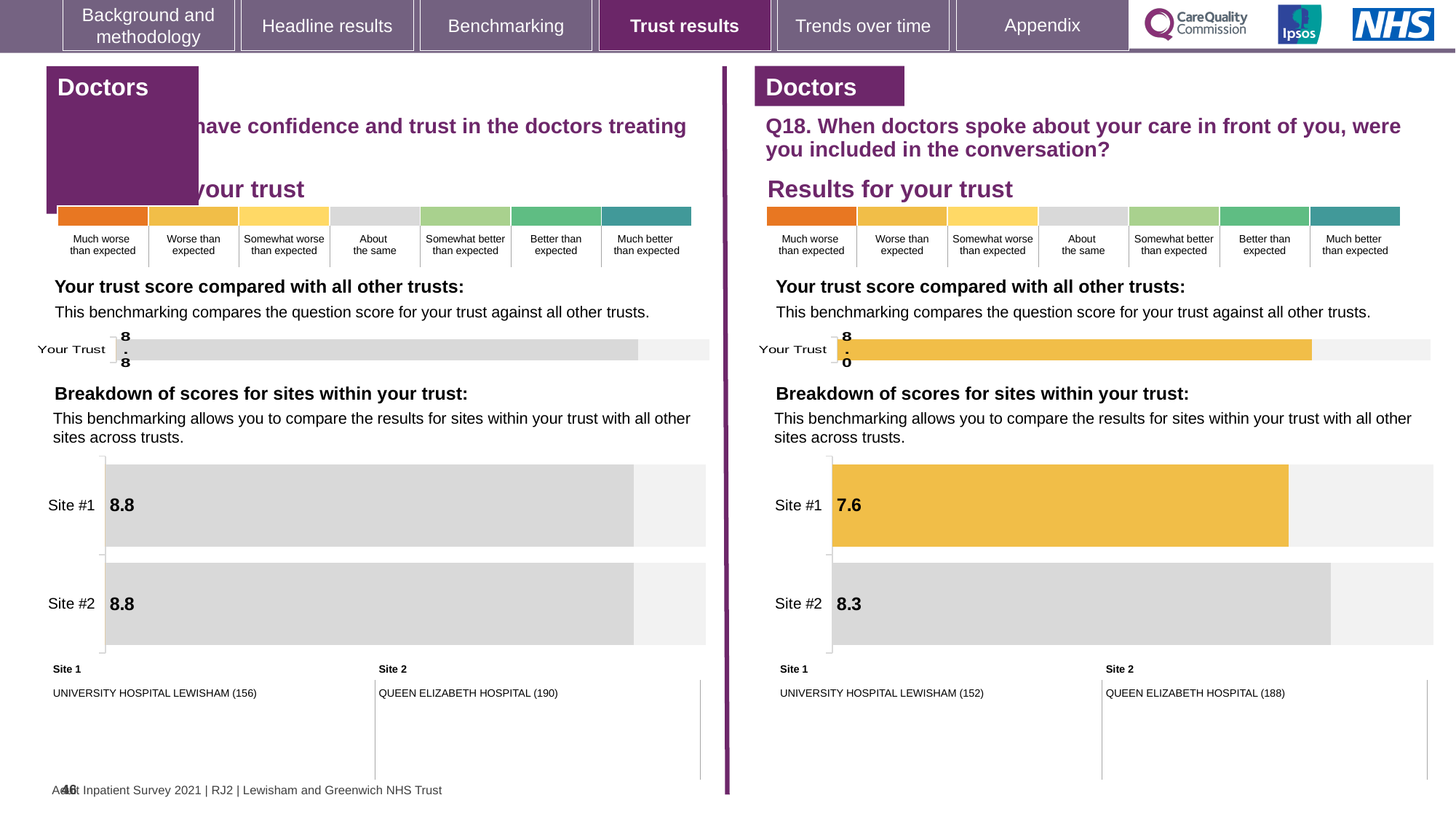
On the right-hand (Q18) 'Breakdown of scores for sites within your trust' chart, what is the score for Site #2? 8.3 On the left-hand 'Your trust score compared with all other trusts' chart, what is the score for Your Trust? 8.8 On the right-hand (Q18) site breakdown chart, what is the difference between the Site #2 and Site #1 scores? 0.7 On the right-hand (Q18) site breakdown chart, what colour is the bar for Site #1? Yellow On the right-hand (Q18) 'Breakdown of scores for sites within your trust' chart, what is the score for Site #1? 7.6 On the left-hand 'Breakdown of scores for sites within your trust' chart, what is the score for Site #1? 8.8 What type of chart is used for the 'Breakdown of scores for sites within your trust' on the right-hand side? Bar chart On the right-hand (Q18) site breakdown chart, which site has the lowest score? Site #1 On the right-hand (Q18) site breakdown chart, which site has the higher score? Site #2 On the right-hand (Q18) site breakdown chart, is the score for Site #2 larger or smaller than the score for Site #1? larger On the right-hand (Q18) 'Your trust score compared with all other trusts' chart, what is the score for Your Trust? 8.0 How many sites are shown on the left-hand 'Breakdown of scores for sites within your trust' chart? 2